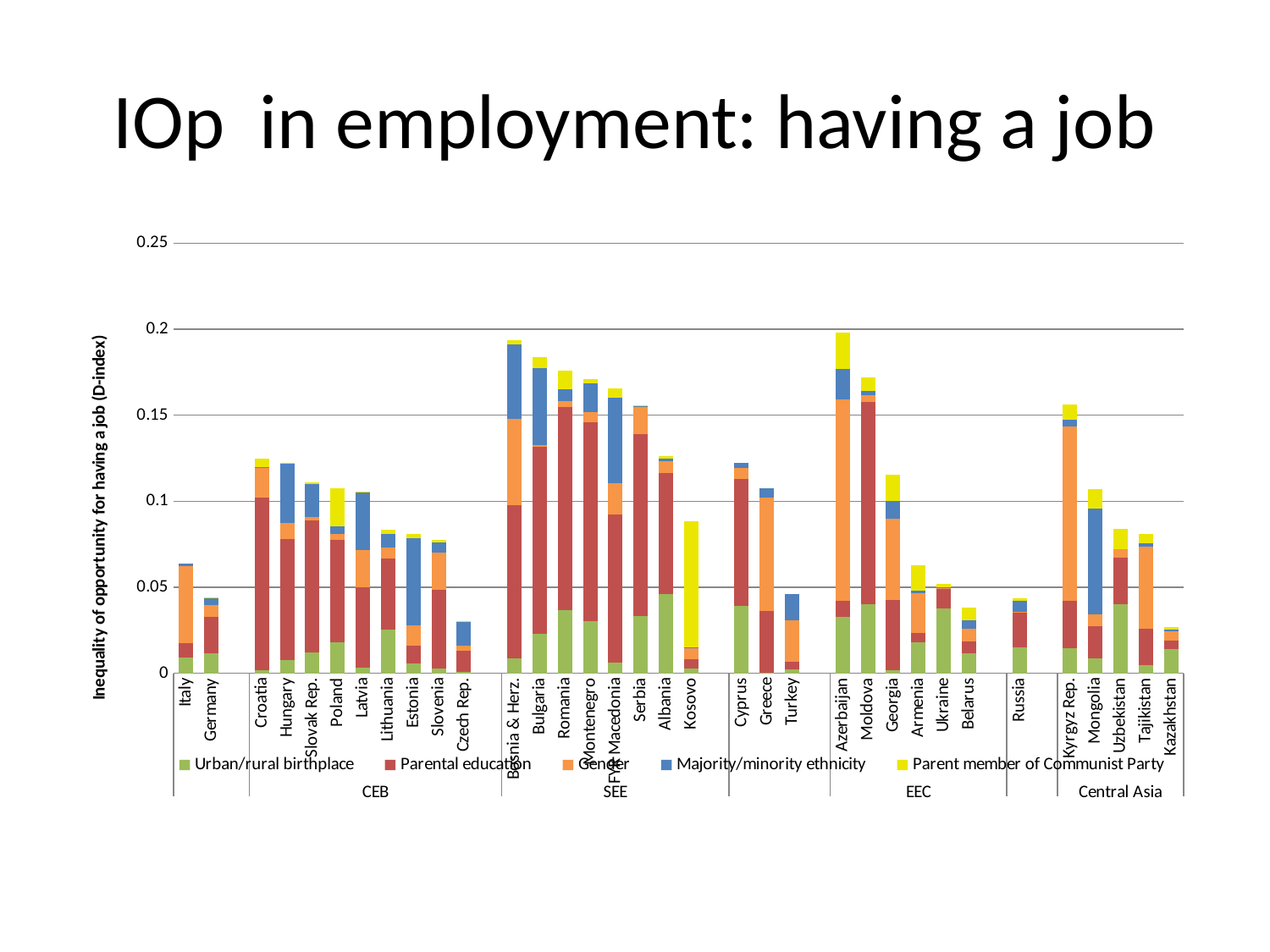
Is the total value for Kosovo greater or less than 0.05? greater Is the total value for Azerbaijan greater or less than 0.15? greater Which legend entry is shown in yellow? Parent member of Communist Party Which has the larger total value, Croatia or Germany? Croatia Is the total value for Croatia greater or less than 0.1? greater Which has the larger total value, Moldova or Georgia? Moldova How many series does the legend list? 5 What is the title of the slide? IOp in employment: having a job What kind of chart is shown on the slide? stacked bar chart How many countries are plotted along the x axis? 34